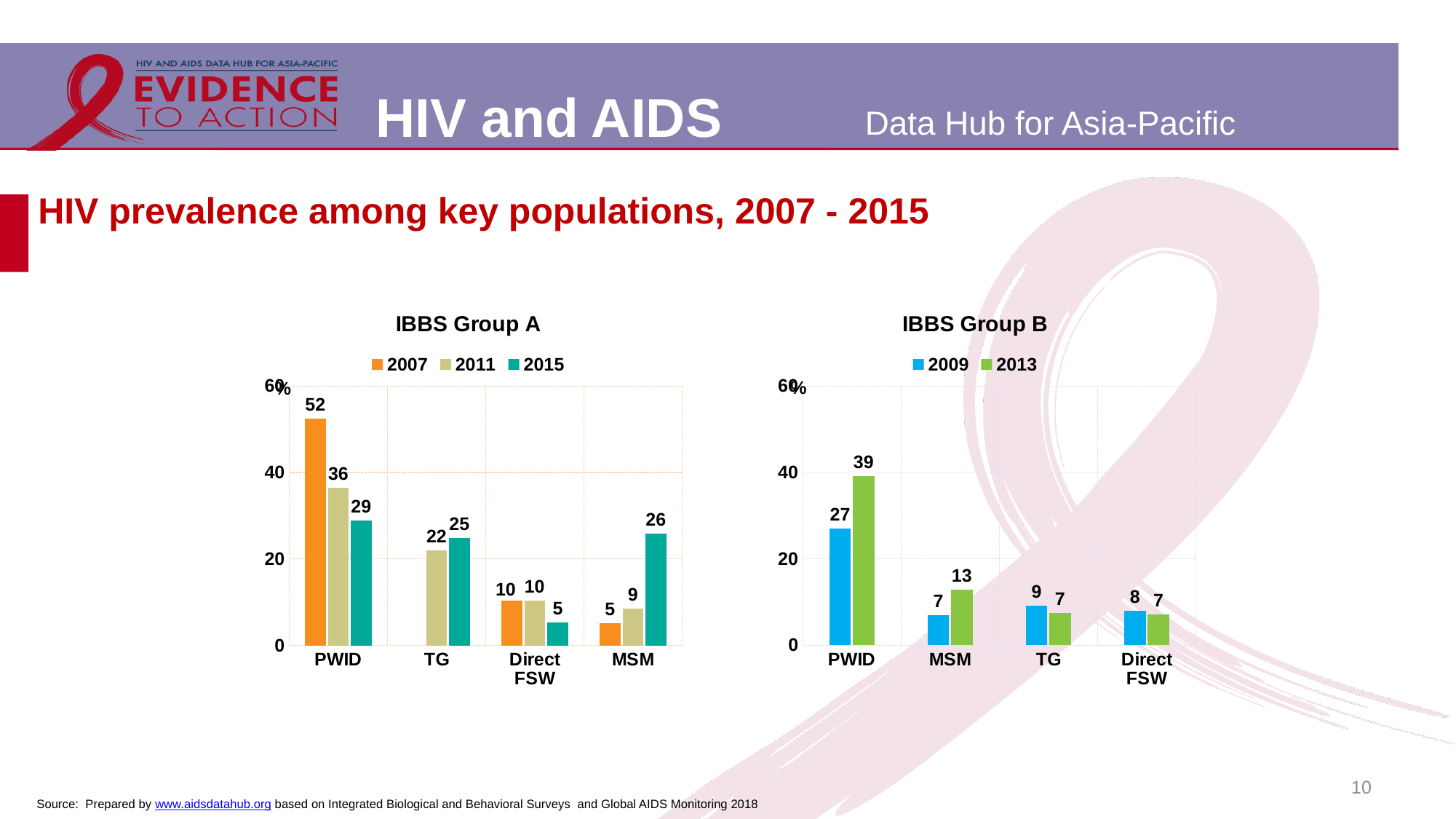
In the IBBS Group B chart, what is the value for MSM in 2009? 7 In the IBBS Group A chart, which category has the highest 2015 value? PWID In the IBBS Group A chart, what is the value for PWID in 2007? 52 In the IBBS Group B chart, what is the difference between the 2013 and 2009 values for PWID? 12 In the IBBS Group A chart, which is larger: the 2011 value for TG or the 2011 value for MSM? TG How many series does the legend of the IBBS Group B chart list? 2 What kind of chart is the IBBS Group B chart? Bar chart In the IBBS Group A chart, what is the value for MSM in 2015? 26 In the IBBS Group B chart, what is the value for PWID in 2013? 39 In the IBBS Group B chart, which category has the lowest 2013 value? TG and Direct FSW (both 7) In the IBBS Group A chart, what is the difference between the 2007 and 2015 values for PWID? 23 How many categories are shown on the x axis of the IBBS Group A chart? 4